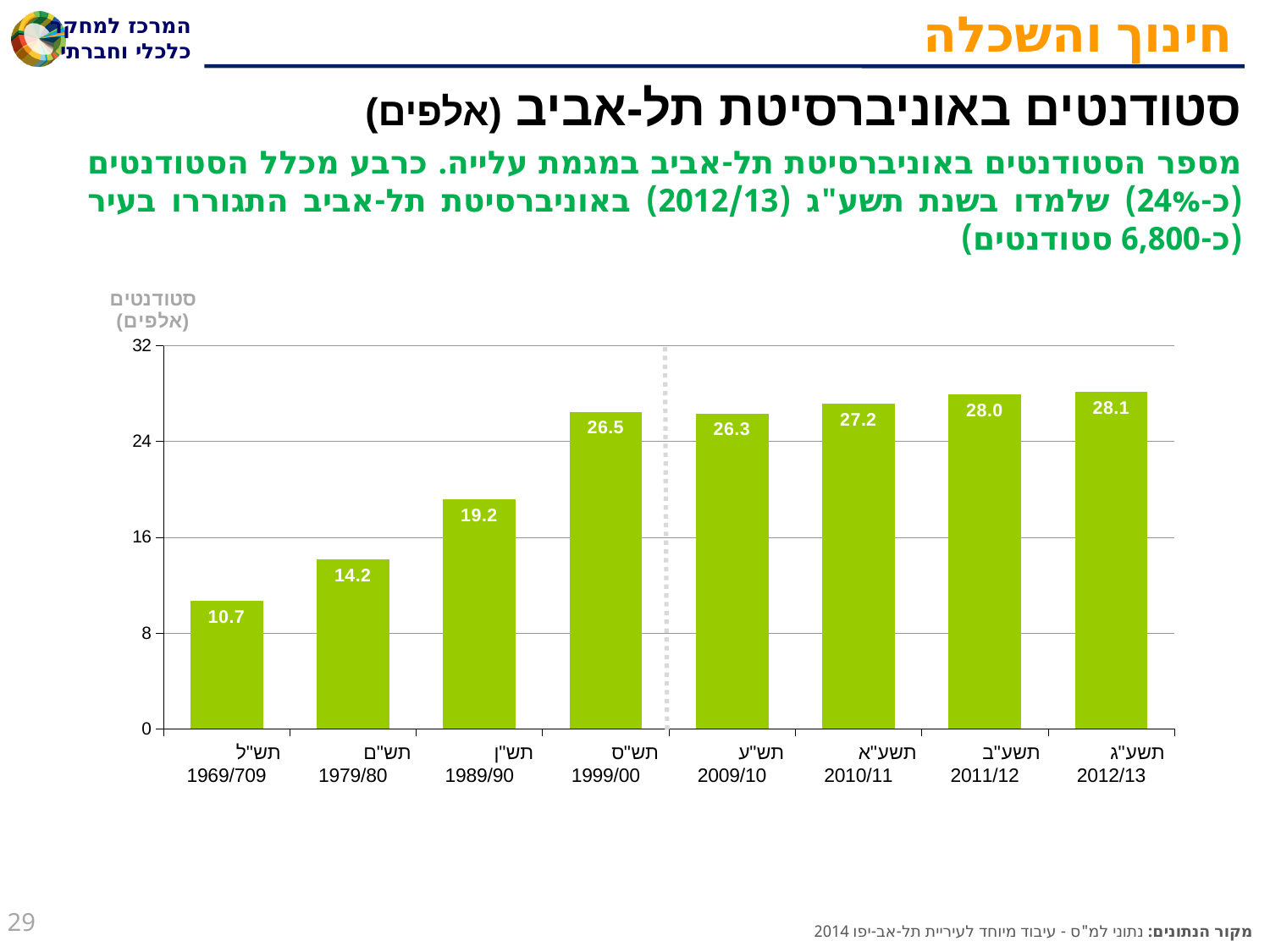
What kind of chart is this? bar chart Which year has the lowest value? 1969/70 (תש"ל) What is the difference between the values for 1999/00 and 2009/10? 0.2 What is the y-axis label of the chart? סטודנטים (אלפים) Which year has the highest value? 2012/13 (תשע"ג) Which is larger, the value for 1989/90 or the value for 1979/80? 1989/90 How many years are shown on the x axis? 8 What is the value for 1969/70 (תש"ל)? 10.7 What is the value for 1999/00 (תש"ס)? 26.5 Is the value for 2010/11 greater or less than 24? greater What is the difference between the values for 2012/13 and 1969/70? 17.4 What is the value for 2012/13 (תשע"ג)? 28.1